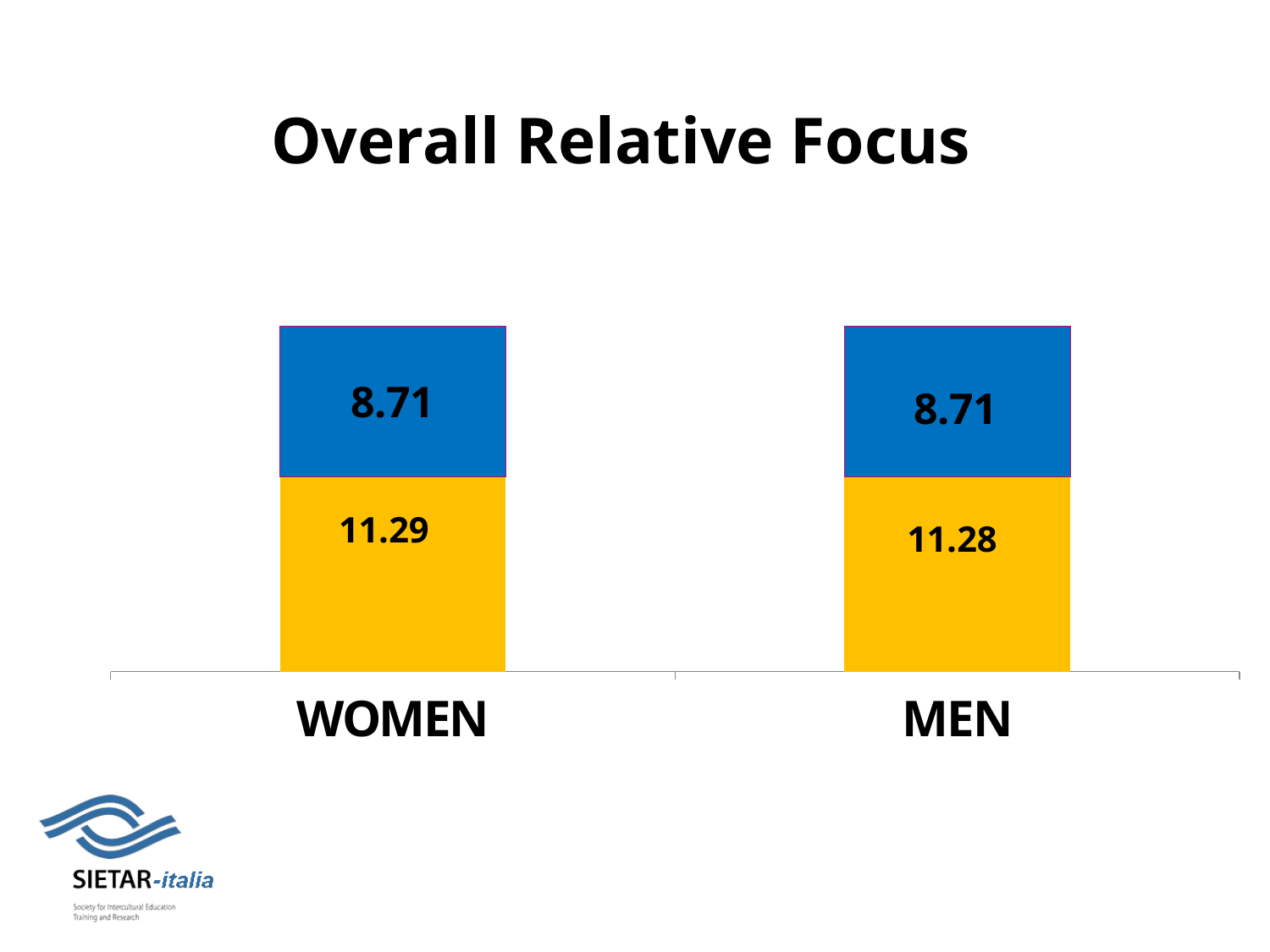
For MEN, what is the difference between the yellow segment and the blue segment? 2.57 What kind of chart is shown on the slide? stacked bar chart What is the total of the stacked bar for WOMEN? 20.00 What is the total of the stacked bar for MEN? 19.99 How many categories are shown on the x axis? 2 What is the value of the yellow segment for MEN? 11.28 What is the title of the chart? Overall Relative Focus What is the value of the yellow segment for WOMEN? 11.29 For WOMEN, which segment is larger, the yellow one or the blue one? yellow What is the value of the blue segment for WOMEN? 8.71 What is the value of the blue segment for MEN? 8.71 What is the difference between the yellow segment for WOMEN and the yellow segment for MEN? 0.01